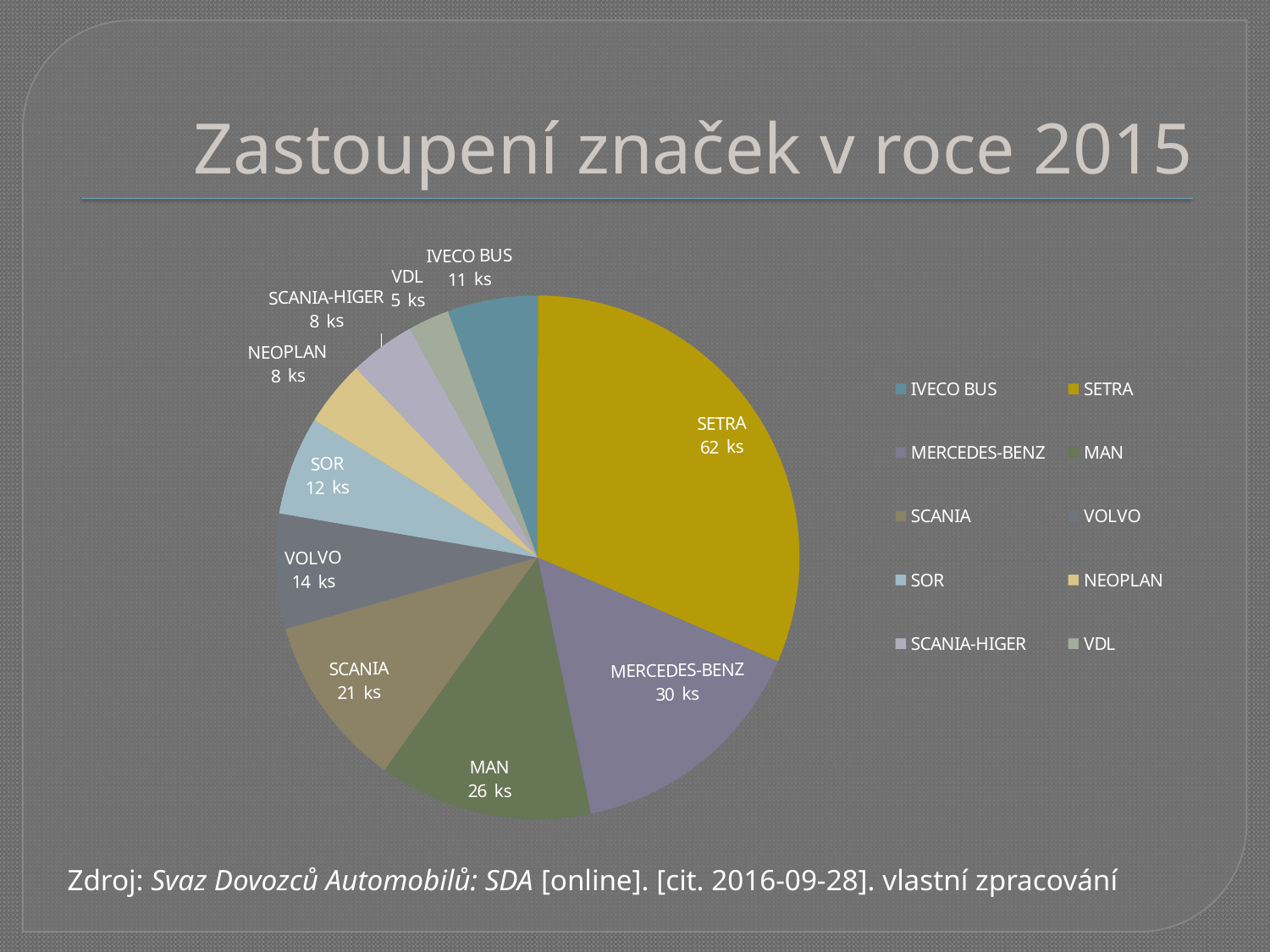
Which brand has the largest slice of the pie chart? SETRA How many units (ks) does SETRA have in the pie chart? 62 ks What is the difference between the values for MAN and SCANIA? 5 ks What is the value shown for VDL? 5 ks What kind of chart is shown on the slide? Pie chart Which brand has the smallest slice of the pie chart? VDL How many brands (slices) are shown in the pie chart? 10 What is the value shown for MERCEDES-BENZ? 30 ks Which is larger, the value for VOLVO or the value for SOR? VOLVO What is the title of the slide containing the chart? Zastoupení značek v roce 2015 How many entries does the legend list? 10 What is the difference between the values for SETRA and MERCEDES-BENZ? 32 ks